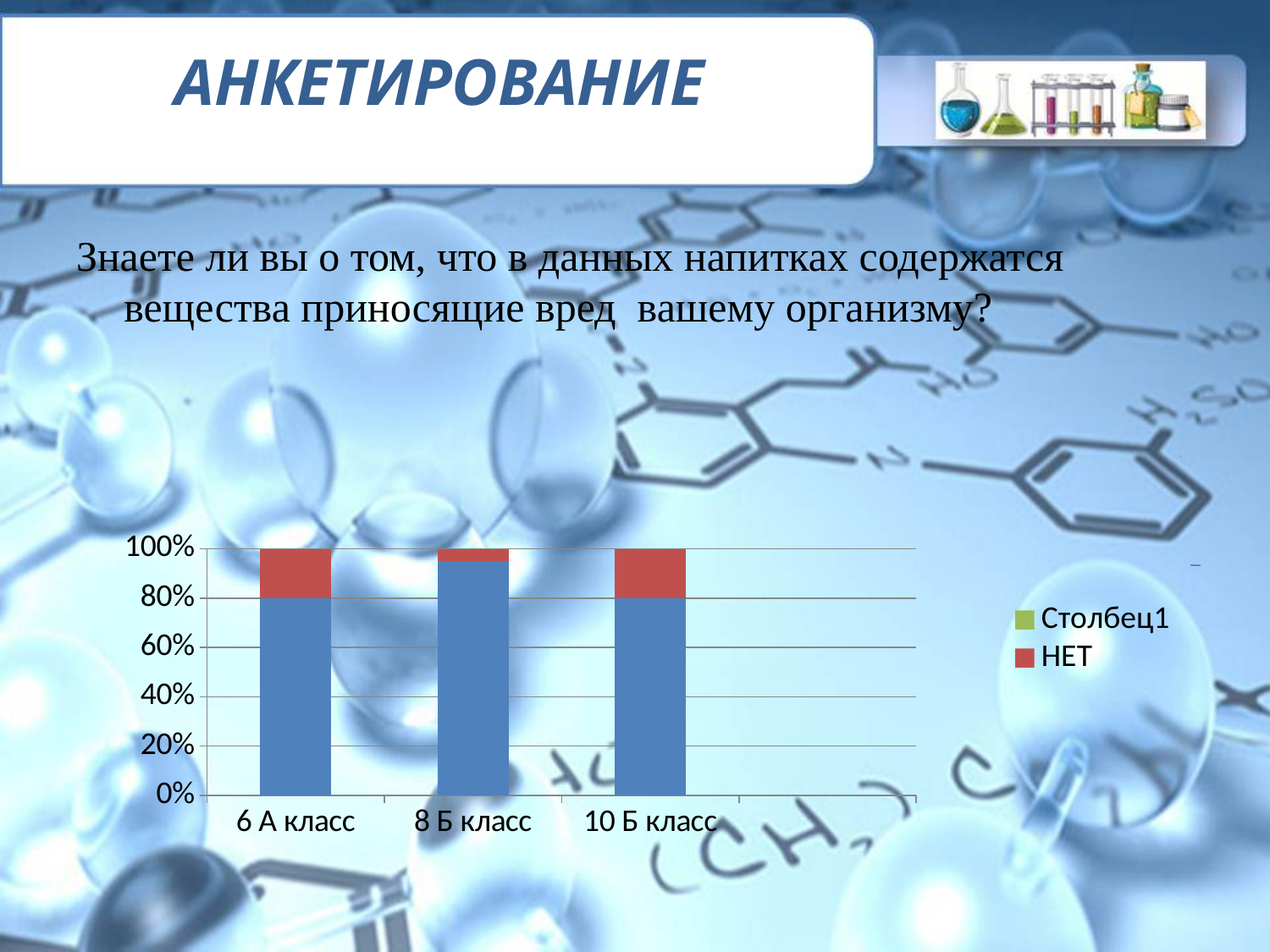
What kind of chart is shown on the slide? bar chart Is the blue (bottom) segment for 6 А класс greater or less than 60%? greater How many classes (categories) are shown on the x axis of the chart? 3 What are the two entries listed in the chart legend? Столбец1 and НЕТ Which class has the smallest red (НЕТ) segment? 8 Б класс What colour is used for the НЕТ series in the legend? red Which class has the tallest blue (bottom) segment? 8 Б класс Which class has a larger blue (bottom) segment, 6 А класс or 8 Б класс? 8 Б класс Is the blue (bottom) segment for 8 Б класс greater or less than 80%? greater Is the blue (bottom) segment for 10 Б класс greater or less than 60%? greater Which class has a larger red (НЕТ) segment, 8 Б класс or 10 Б класс? 10 Б класс How many series does the chart legend list? 2